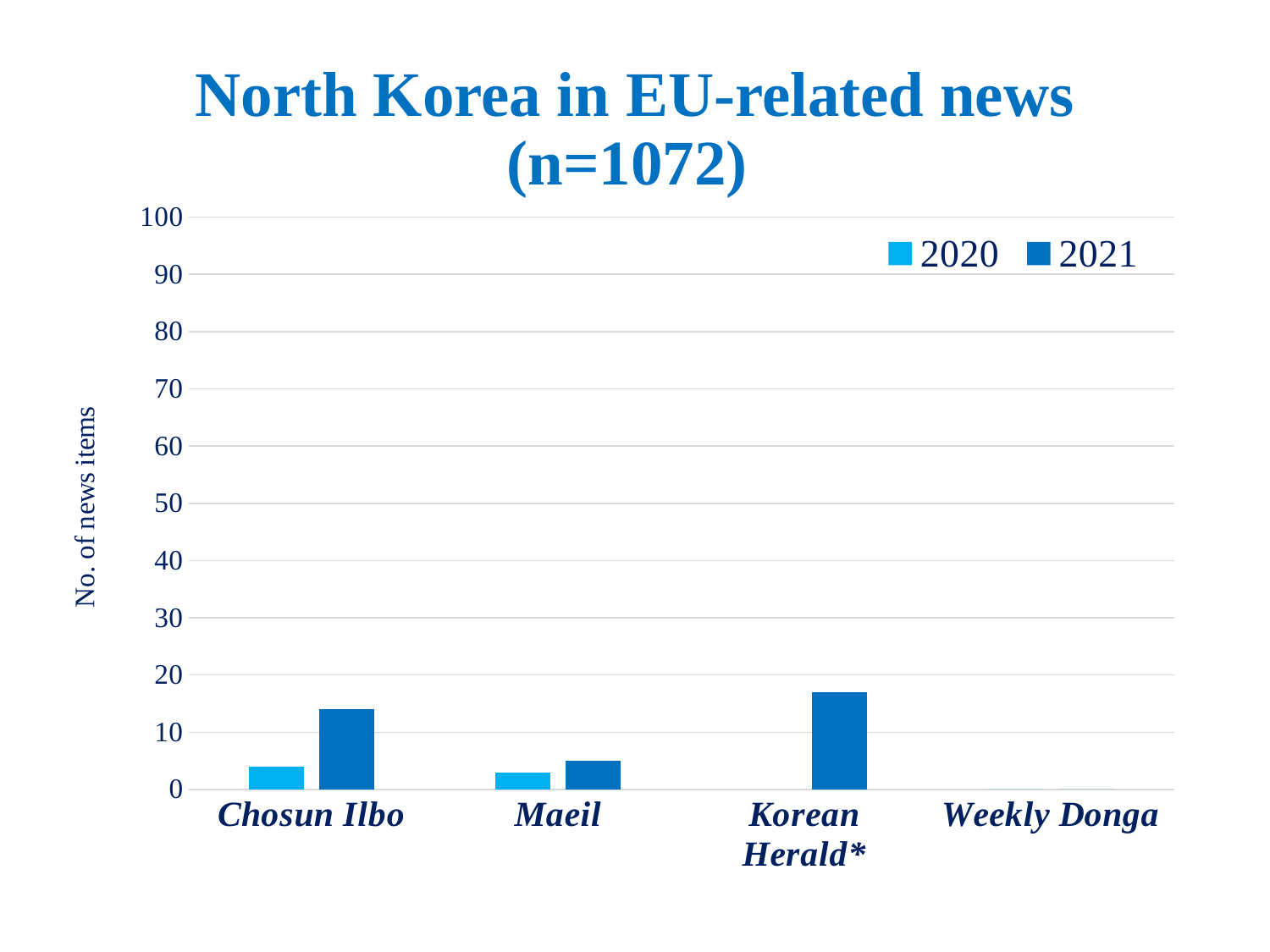
Is the 2021 value for Maeil greater or less than 10? less What is the label on the y axis? No. of news items How many news outlets are shown on the x axis? 4 Is the 2021 value for Korean Herald* greater or less than 10? greater Which is larger, the 2021 value for Chosun Ilbo or the 2021 value for Maeil? Chosun Ilbo Which news outlet has the lowest value for 2021? Weekly Donga How many series does the legend list? 2 What is the title of the chart? North Korea in EU-related news (n=1072) Is the 2021 value for Chosun Ilbo greater or less than 10? greater Which news outlet has the highest value for 2021? Korean Herald* What kind of chart is shown on the slide? bar chart